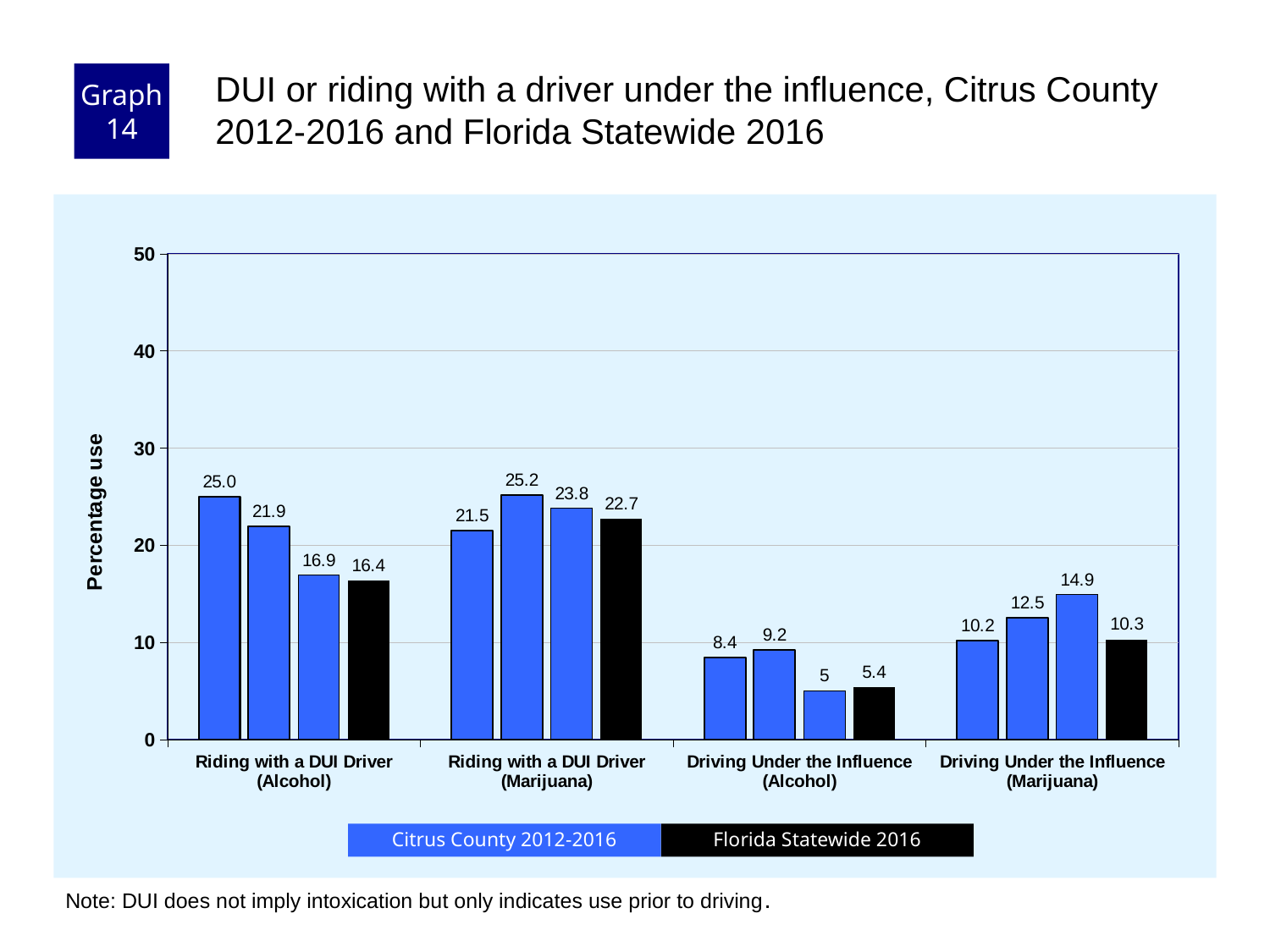
For Florida Statewide 2016, which is larger: Driving Under the Influence (Alcohol) or Driving Under the Influence (Marijuana)? Driving Under the Influence (Marijuana) Which category contains the tallest bar on the chart? Riding with a DUI Driver (Marijuana) Do the Citrus County bars for Driving Under the Influence (Marijuana) rise or fall from left to right? rise How many series does the legend list? 2 How many categories are shown on the x axis? 4 What is the value of the first (leftmost) Citrus County bar for Riding with a DUI Driver (Alcohol)? 25.0 What is the difference between the Florida Statewide 2016 values for Riding with a DUI Driver (Marijuana) and Riding with a DUI Driver (Alcohol)? 6.3 What is the Florida Statewide 2016 value for Riding with a DUI Driver (Alcohol)? 16.4 What is the lowest value shown on the chart? 5 Is the Florida Statewide 2016 value for Riding with a DUI Driver (Marijuana) greater or less than 20? greater What is the Florida Statewide 2016 value for Driving Under the Influence (Marijuana)? 10.3 What kind of chart is shown on the slide? bar chart